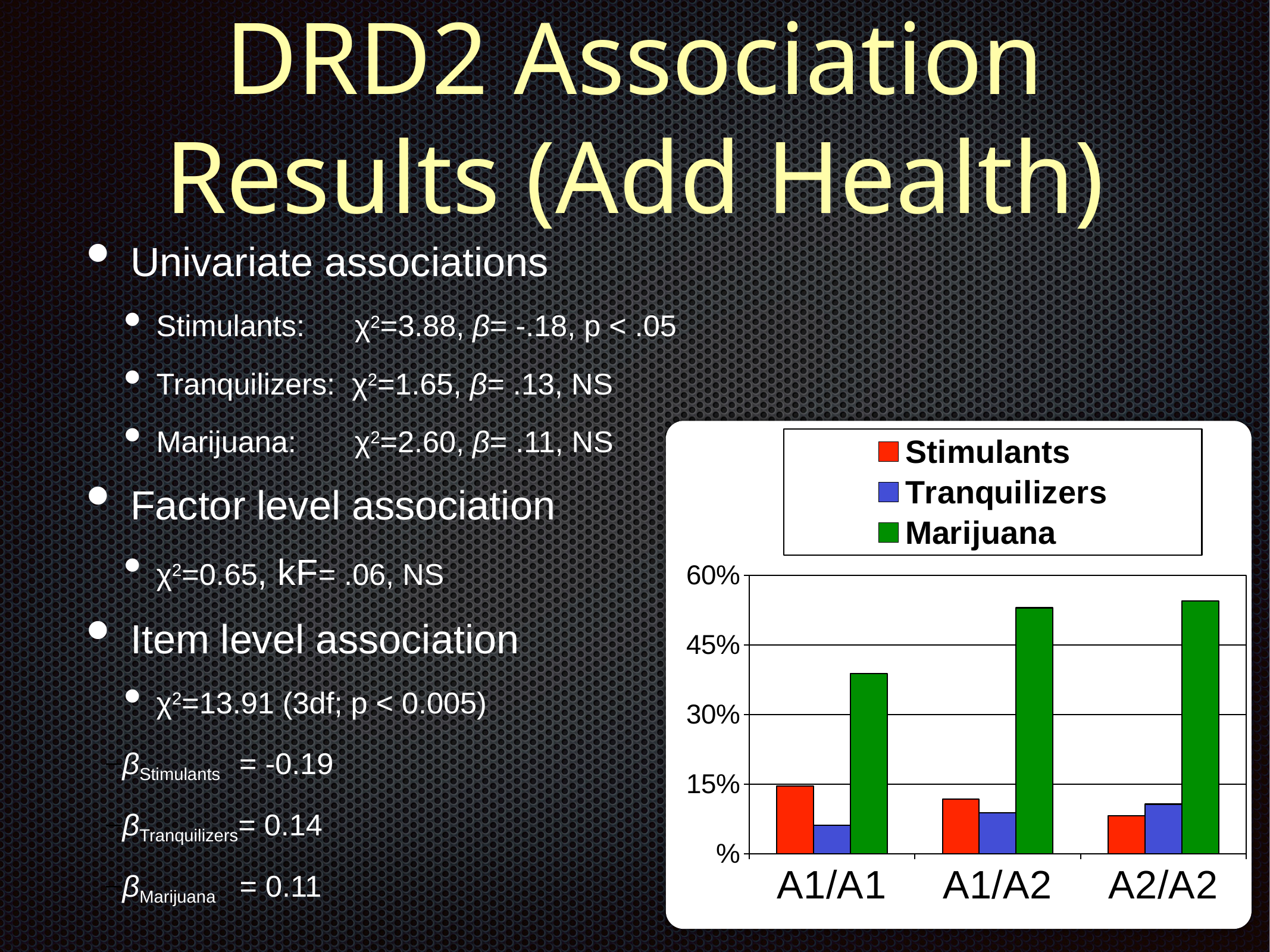
Is the Tranquilizers value for A1/A1 greater or less than 15%? less Which colour represents Marijuana in the chart legend? green How many series does the chart legend list? 3 Which series has the highest value for the A1/A1 genotype? Marijuana Which series has the lowest value for the A2/A2 genotype? Stimulants For the A1/A1 genotype, is the Stimulants value or the Tranquilizers value larger? Stimulants Do the Stimulants values rise or fall moving from A1/A1 to A2/A2 along the x axis? fall What kind of chart is shown on the slide? bar chart Is the Marijuana value for A1/A2 greater or less than 45%? greater Is the Marijuana value for A1/A1 greater or less than 45%? less Which series has the lowest value for the A1/A1 genotype? Tranquilizers How many genotype categories are shown on the x axis of the chart? 3